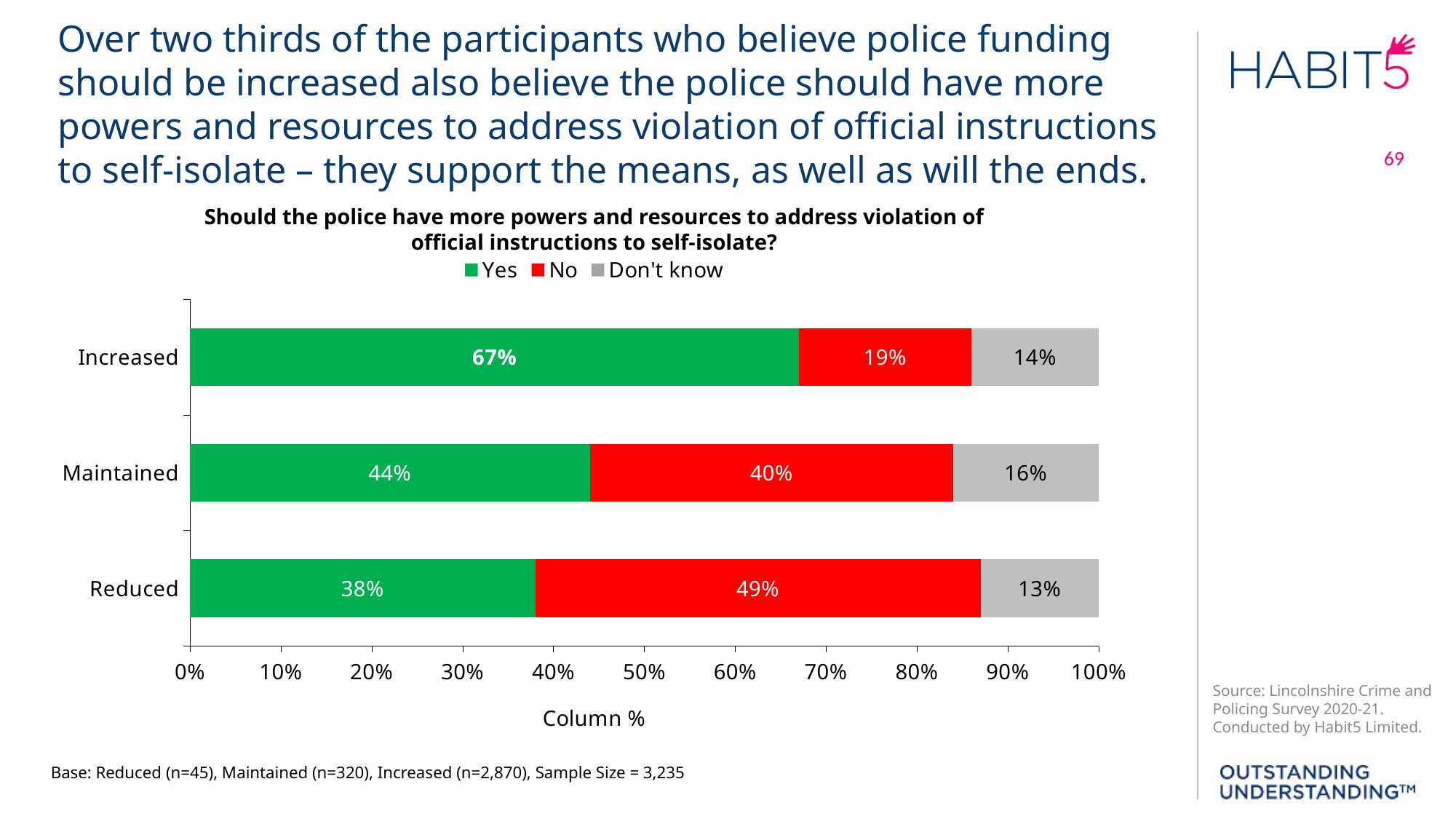
What percentage of participants in the Reduced group answered Don't know? 13% What is the total of the stacked bar for the Maintained group? 100% What colour represents the Don't know series in the chart? Grey How many series does the legend list? 3 What percentage of participants in the Increased group answered Yes? 67% What kind of chart is shown on the slide? Stacked bar chart Which group has the lowest No percentage? Increased How many groups (categories) are shown on the chart? 3 Which group has the highest Yes percentage? Increased What is the difference between the Yes percentages for the Increased and Reduced groups? 29% Which is larger: the No percentage for Reduced or the No percentage for Maintained? Reduced What percentage of participants in the Maintained group answered No? 40%